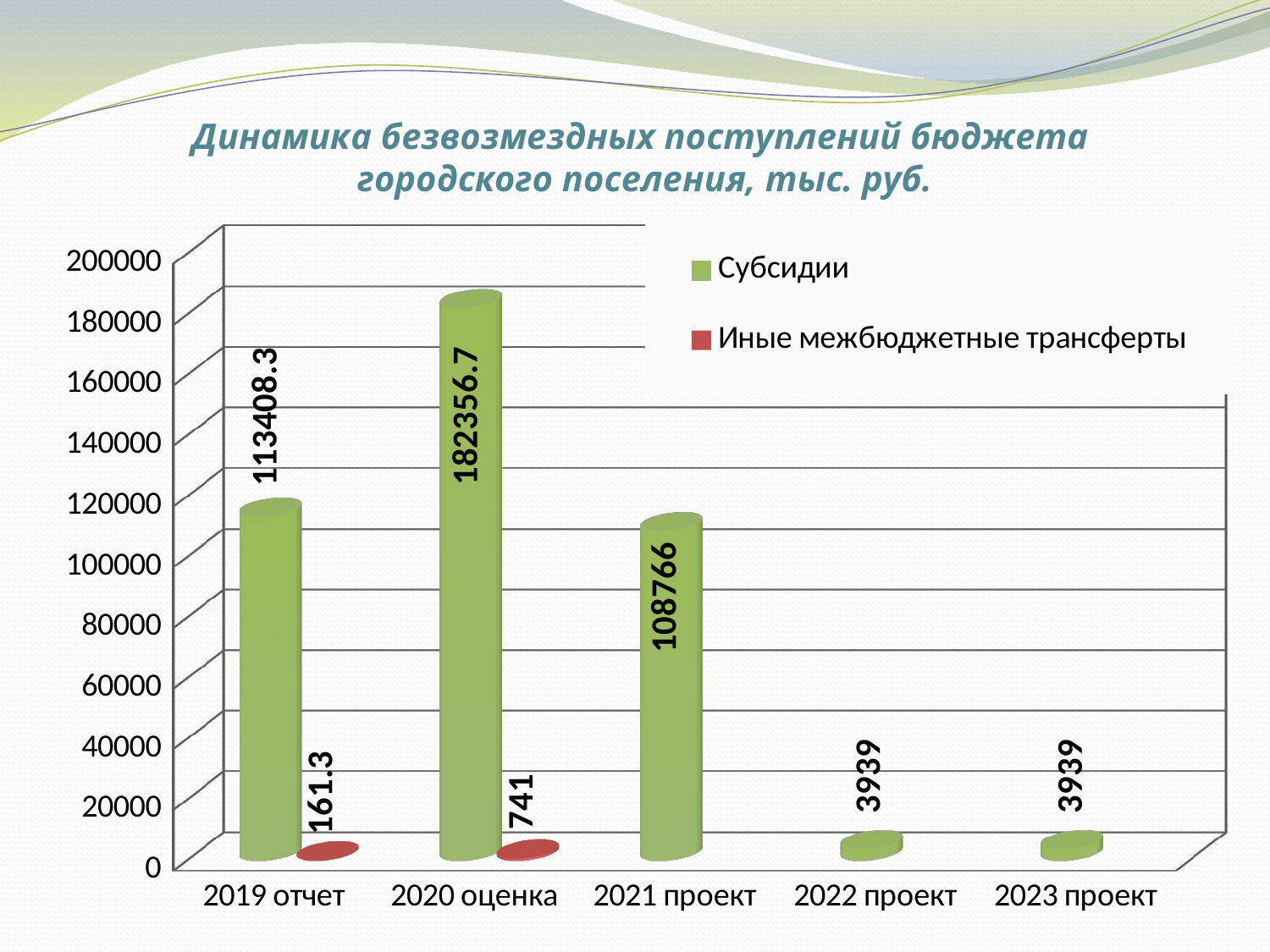
How many series does the legend list? 2 What is the value of Субсидии for 2023 проект? 3939 What is the difference between the Субсидии values for 2020 оценка and 2021 проект? 73590.7 What is the value of Субсидии for 2019 отчет? 113408.3 How many categories are shown on the x axis? 5 Which colour represents Иные межбюджетные трансферты in the legend? Red What is the value of Иные межбюджетные трансферты for 2020 оценка? 741 Which is larger: Субсидии for 2019 отчет or Субсидии for 2021 проект? 2019 отчет In which category is the value of Субсидии highest? 2020 оценка What kind of chart is shown on the slide? Bar chart What is the value of Иные межбюджетные трансферты for 2019 отчет? 161.3 What is the value of Субсидии for 2020 оценка? 182356.7